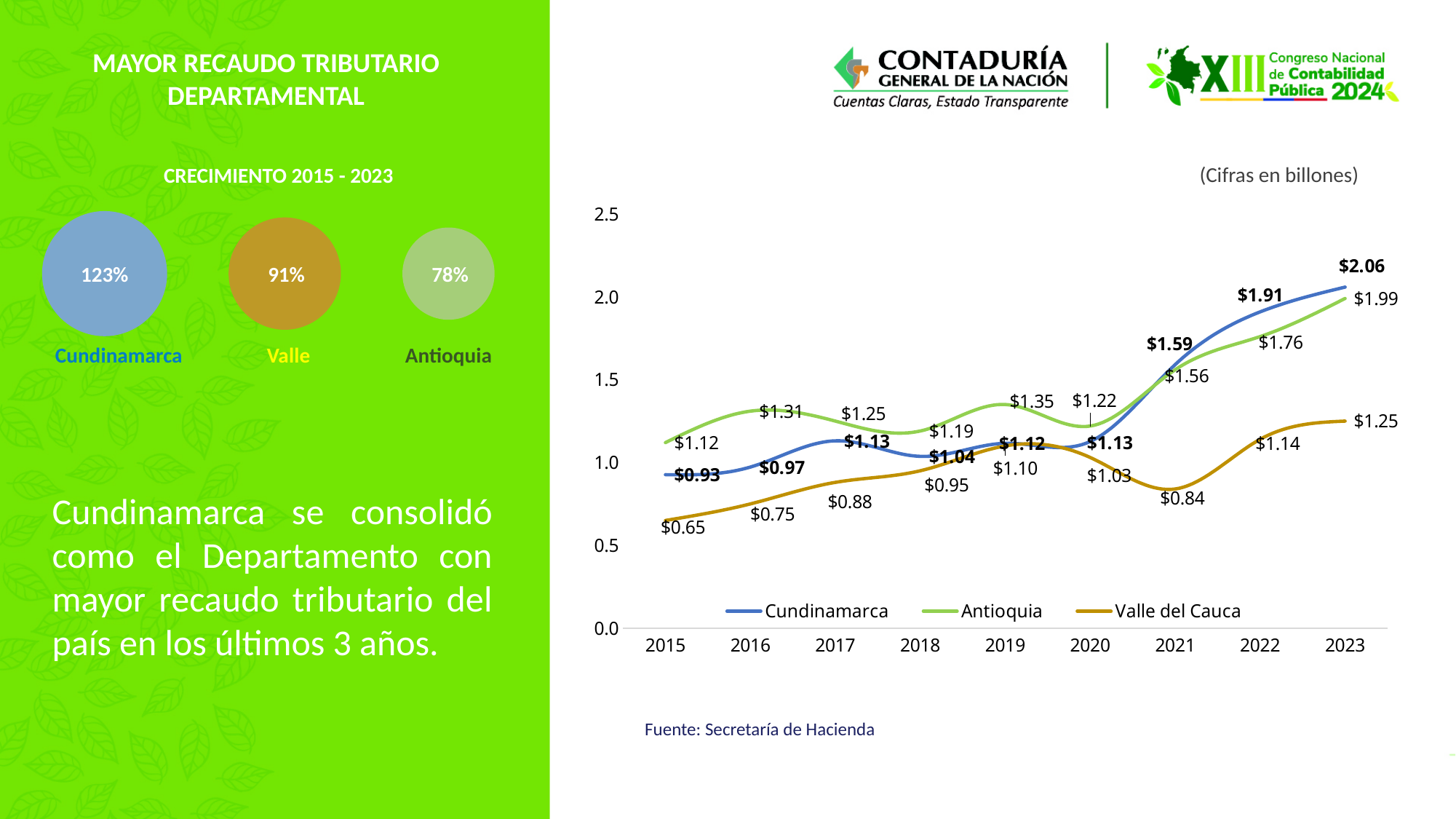
How many years are shown on the x axis of the chart? 9 What is the value for Antioquia in 2019? $1.35 Which is larger in 2016, Cundinamarca or Antioquia? Antioquia What type of chart is shown on the slide? line chart How many series does the chart legend list? 3 Which series has the highest value in 2023? Cundinamarca Does the Cundinamarca series rise or fall between 2020 and 2023? rise What unit note is shown above the chart? (Cifras en billones) In which year does Valle del Cauca reach its lowest value? 2015 What is the value for Valle del Cauca in 2015? $0.65 What is the difference between Cundinamarca and Antioquia in 2023? $0.07 What is the value for Cundinamarca in 2023? $2.06